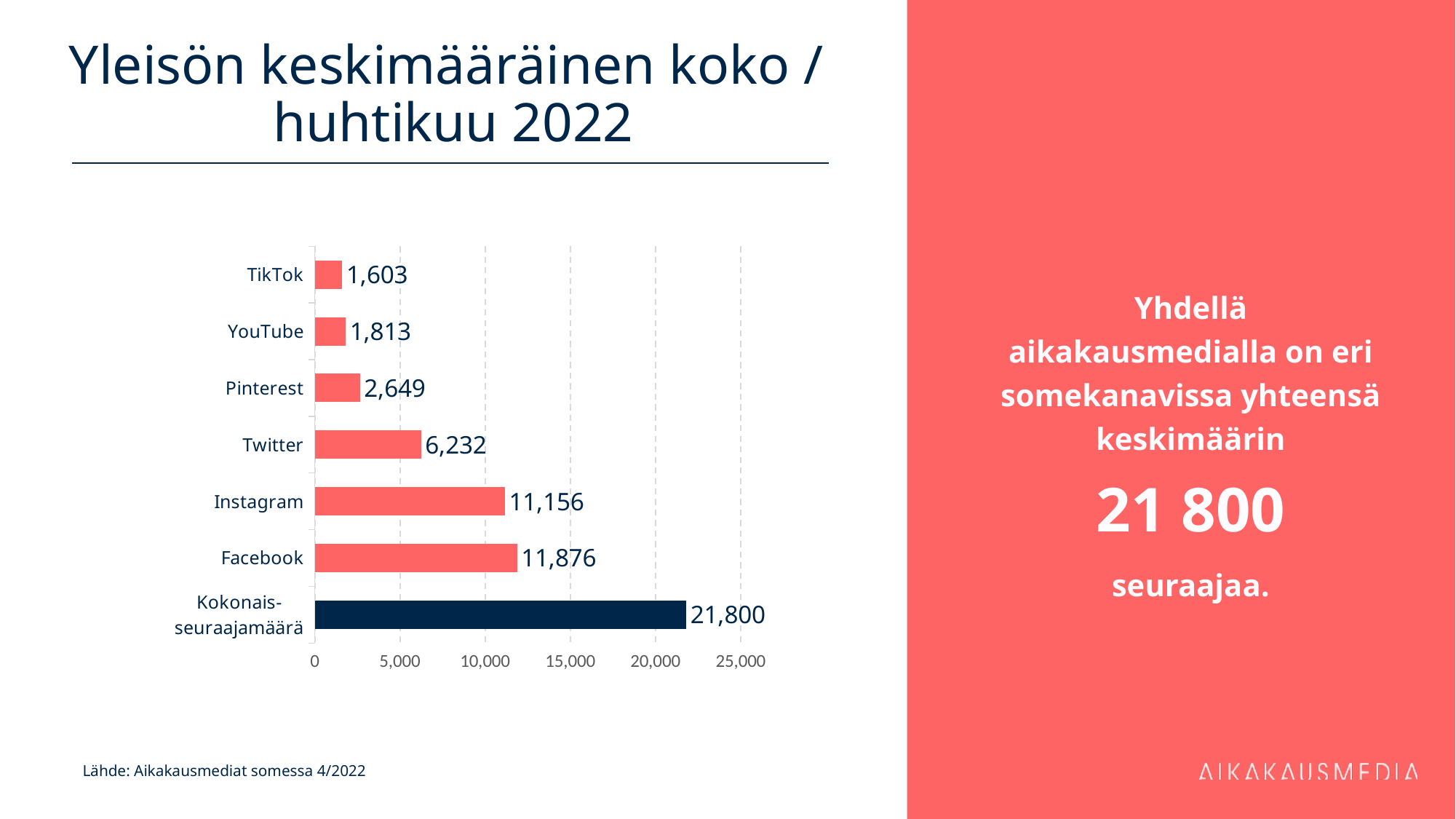
Which category has the lowest value? TikTok What kind of chart is shown on the slide? bar chart What is the difference between the values for Facebook and Instagram? 720 What is the value for Facebook? 11,876 Which is larger, the value for YouTube or the value for Pinterest? Pinterest How many categories are shown in the chart? 7 What is the value for TikTok? 1,603 Which category has the highest value? Kokonais-seuraajamäärä What is the value for Twitter? 6,232 What is the value for Kokonais-seuraajamäärä? 21,800 Which bar is shown in a different colour (dark navy) from the others? Kokonais-seuraajamäärä What is the difference between the values for Twitter and Pinterest? 3,583